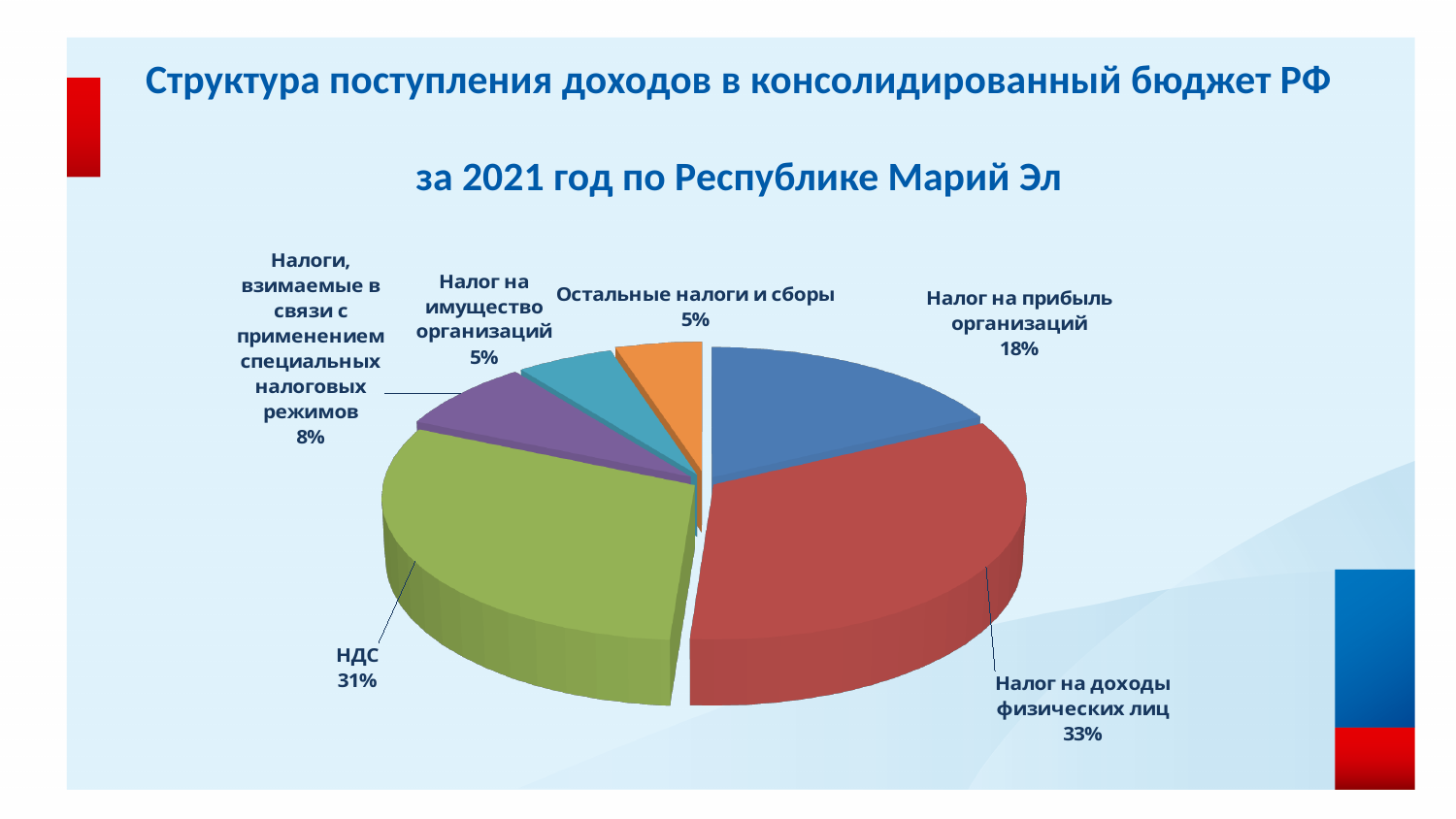
What is the value shown for "Налог на прибыль организаций"? 18% What kind of chart is shown on the slide? pie chart What is the title of the chart on the slide? Структура поступления доходов в консолидированный бюджет РФ за 2021 год по Республике Марий Эл What is the value shown for "Налог на имущество организаций"? 5% What is the value shown for "Налоги, взимаемые в связи с применением специальных налоговых режимов"? 8% How many slices does the pie chart have? 6 Which is larger, the share of "НДС" or the share of "Налог на прибыль организаций"? НДС What is the value shown for "НДС"? 31% What share of the pie does "Налог на доходы физических лиц" have? 33% Which category has the largest share of the pie? Налог на доходы физических лиц What is the difference between the shares of "Налог на доходы физических лиц" and "НДС"? 2% What is the value shown for "Остальные налоги и сборы"? 5%